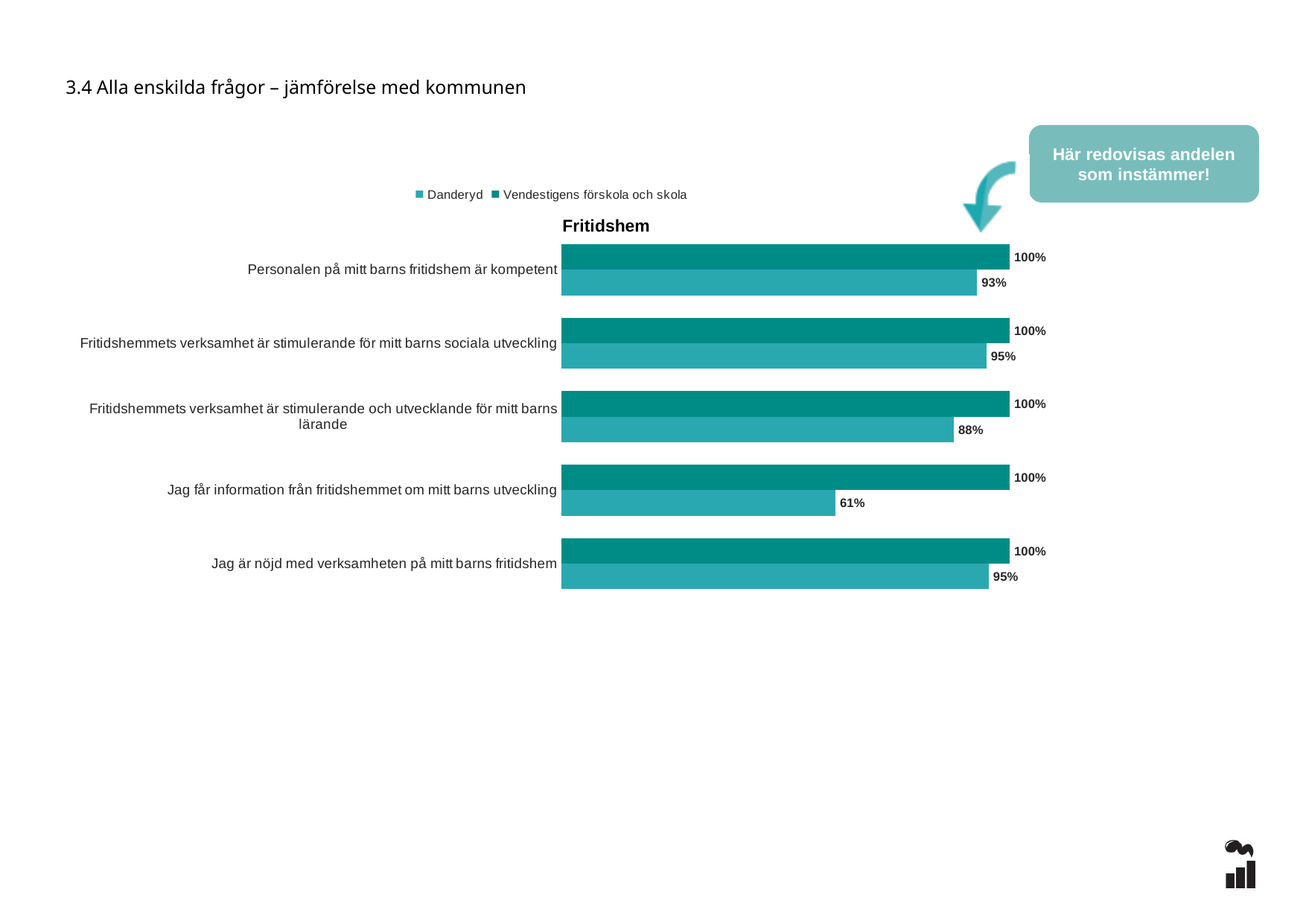
What kind of chart is shown on the slide? Bar chart What is the value for Danderyd for 'Jag får information från fritidshemmet om mitt barns utveckling'? 61% How many statements (categories) are shown in the chart? 5 Which statement has the lowest value for Danderyd? Jag får information från fritidshemmet om mitt barns utveckling How many series does the legend list? 2 What is the value for Danderyd for 'Fritidshemmets verksamhet är stimulerande för mitt barns sociala utveckling'? 95% What is the difference between Vendestigens förskola och skola and Danderyd for 'Jag får information från fritidshemmet om mitt barns utveckling'? 39% What is the difference between Vendestigens förskola och skola and Danderyd for 'Personalen på mitt barns fritidshem är kompetent'? 7% What is the value for Vendestigens förskola och skola for 'Personalen på mitt barns fritidshem är kompetent'? 100% What is the value for Danderyd for 'Fritidshemmets verksamhet är stimulerande och utvecklande för mitt barns lärande'? 88% For 'Jag är nöjd med verksamheten på mitt barns fritidshem', which is larger: Danderyd or Vendestigens förskola och skola? Vendestigens förskola och skola What is the title of the chart? Fritidshem